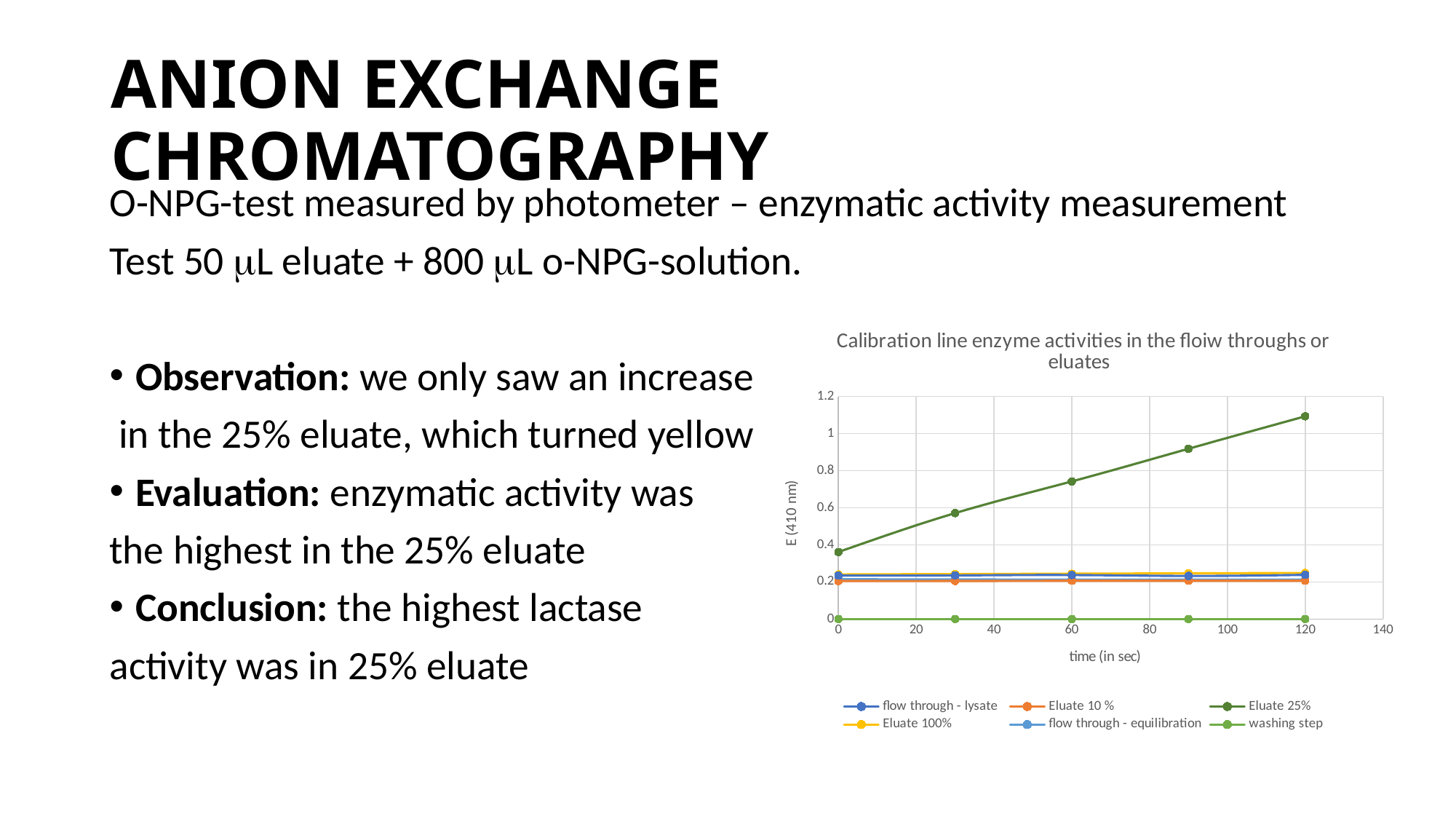
Is the value for Eluate 25% at 0 seconds greater or less than 0.4? less What is the label of the y axis? E (410 nm) At 90 seconds, which is larger: Eluate 25% or Eluate 10 %? Eluate 25% Which series has the highest value at 120 seconds? Eluate 25% Is the value for Eluate 25% at 120 seconds greater or less than 1? greater Which series has the lowest values across all time points? washing step What is the value of the washing step series at 60 seconds? 0 What is the label of the x axis? time (in sec) Does the Eluate 25% series rise or fall as time increases? rises How many time points are plotted for the Eluate 25% series? 5 How many series does the chart legend list? 6 What kind of chart is shown on the slide? line chart